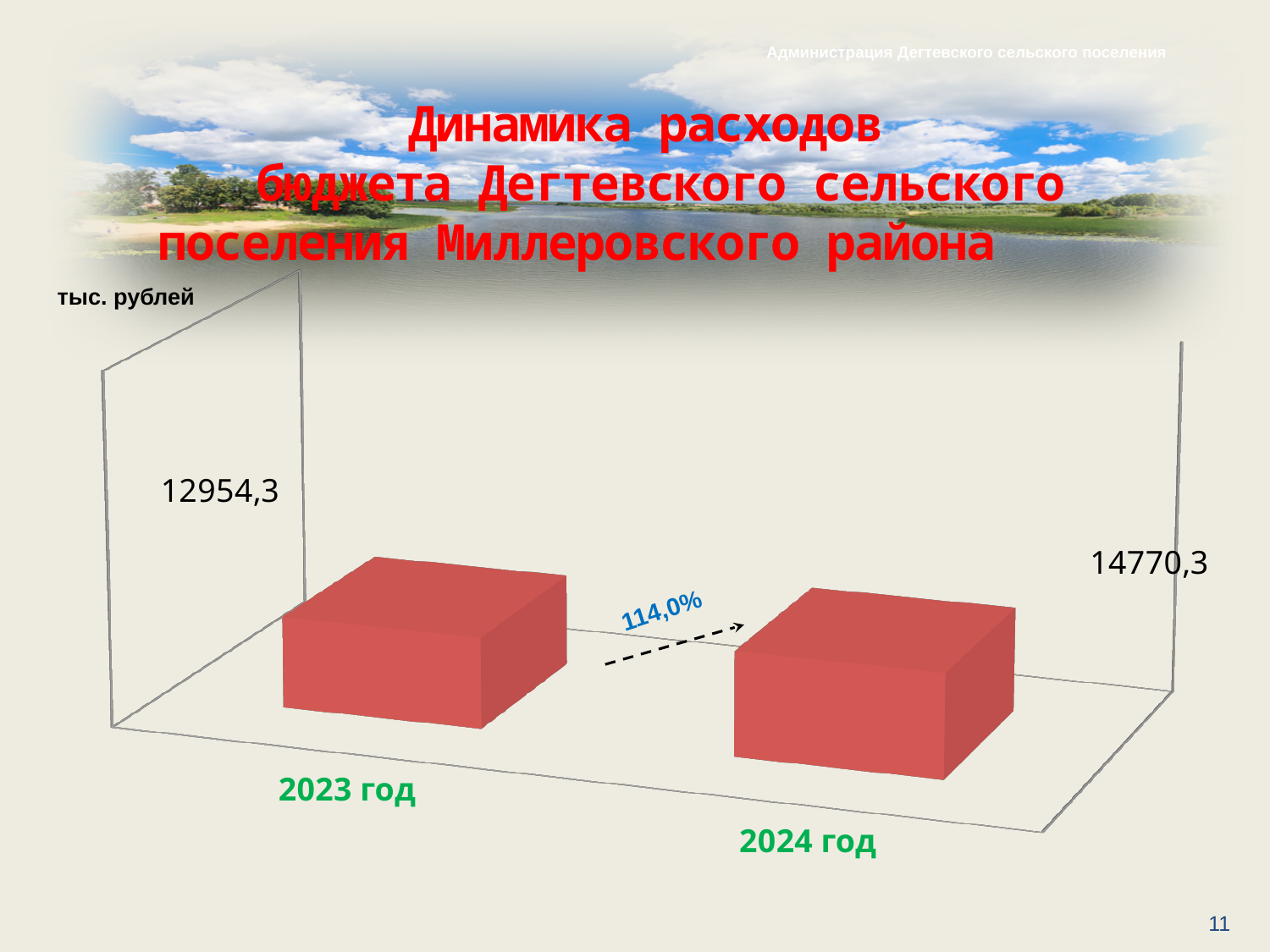
Which year has the higher value? 2024 год What kind of chart is shown on the slide? bar chart Do the values rise or fall from 2023 год to 2024 год? rise What is the value for 2023 год? 12954,3 What is the difference between the values for 2024 год and 2023 год? 1816,0 Is the value for 2024 год larger or smaller than the value for 2023 год? larger How many categories (years) are shown in the chart? 2 What unit of measurement is indicated on the chart? тыс. рублей What is the value for 2024 год? 14770,3 What percentage is shown on the arrow between the two bars? 114,0% Which year has the lower value? 2023 год